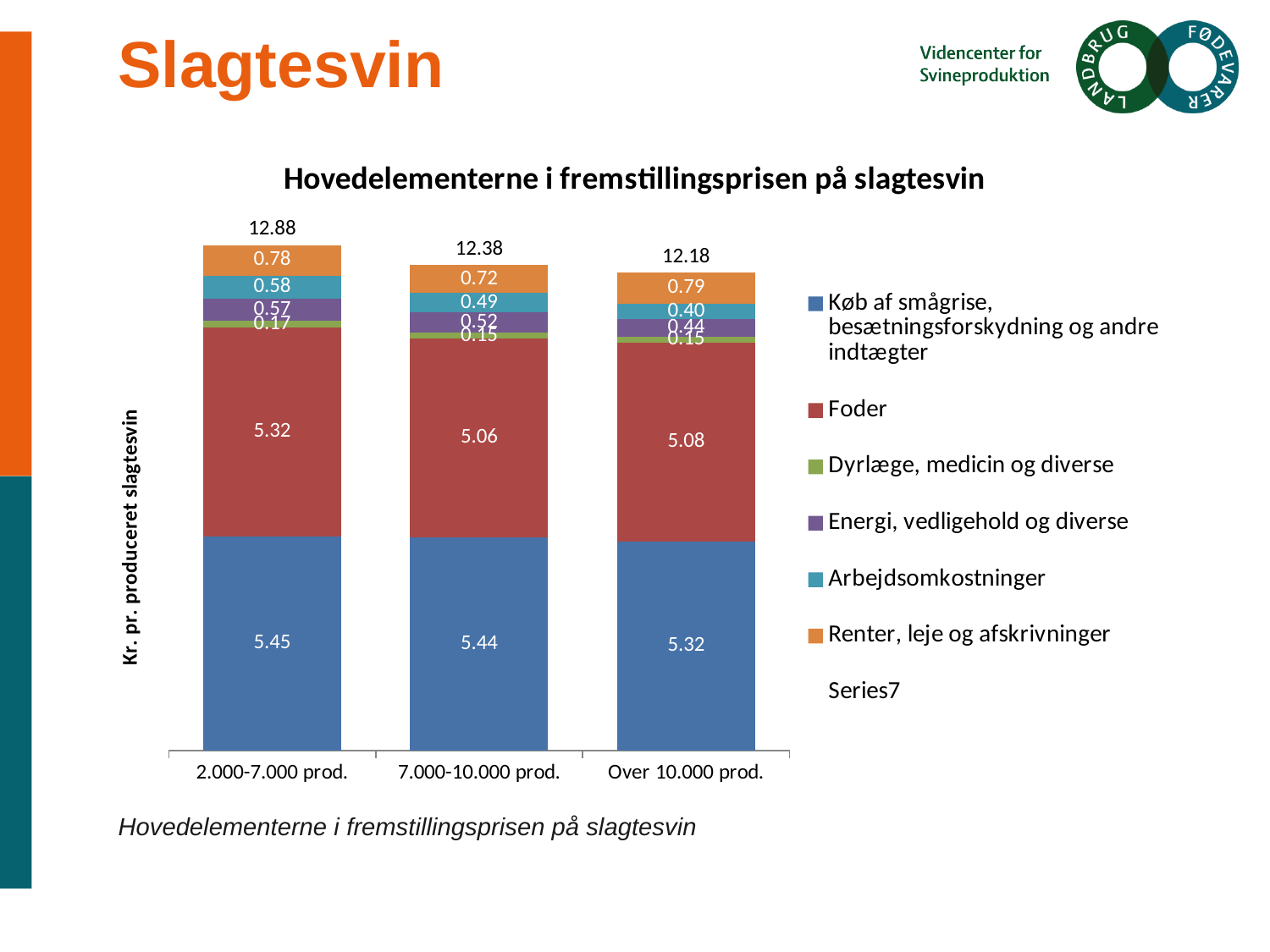
Do the total values rise or fall from 2.000-7.000 prod. to Over 10.000 prod.? fall Which category has the lowest total value? Over 10.000 prod. How many categories are shown on the x axis? 3 What is the difference between the total for 2.000-7.000 prod. and the total for Over 10.000 prod.? 0.70 What type of chart is shown on the slide? stacked bar chart Which category has the highest total value? 2.000-7.000 prod. What is the Foder value for 7.000-10.000 prod.? 5.06 What is the Renter, leje og afskrivninger value for Over 10.000 prod.? 0.79 How many entries does the legend list? 7 What is the Arbejdsomkostninger value for 2.000-7.000 prod.? 0.58 What is the total value of the stacked bar for 2.000-7.000 prod.? 12.88 What is the title of the chart? Hovedelementerne i fremstillingsprisen på slagtesvin